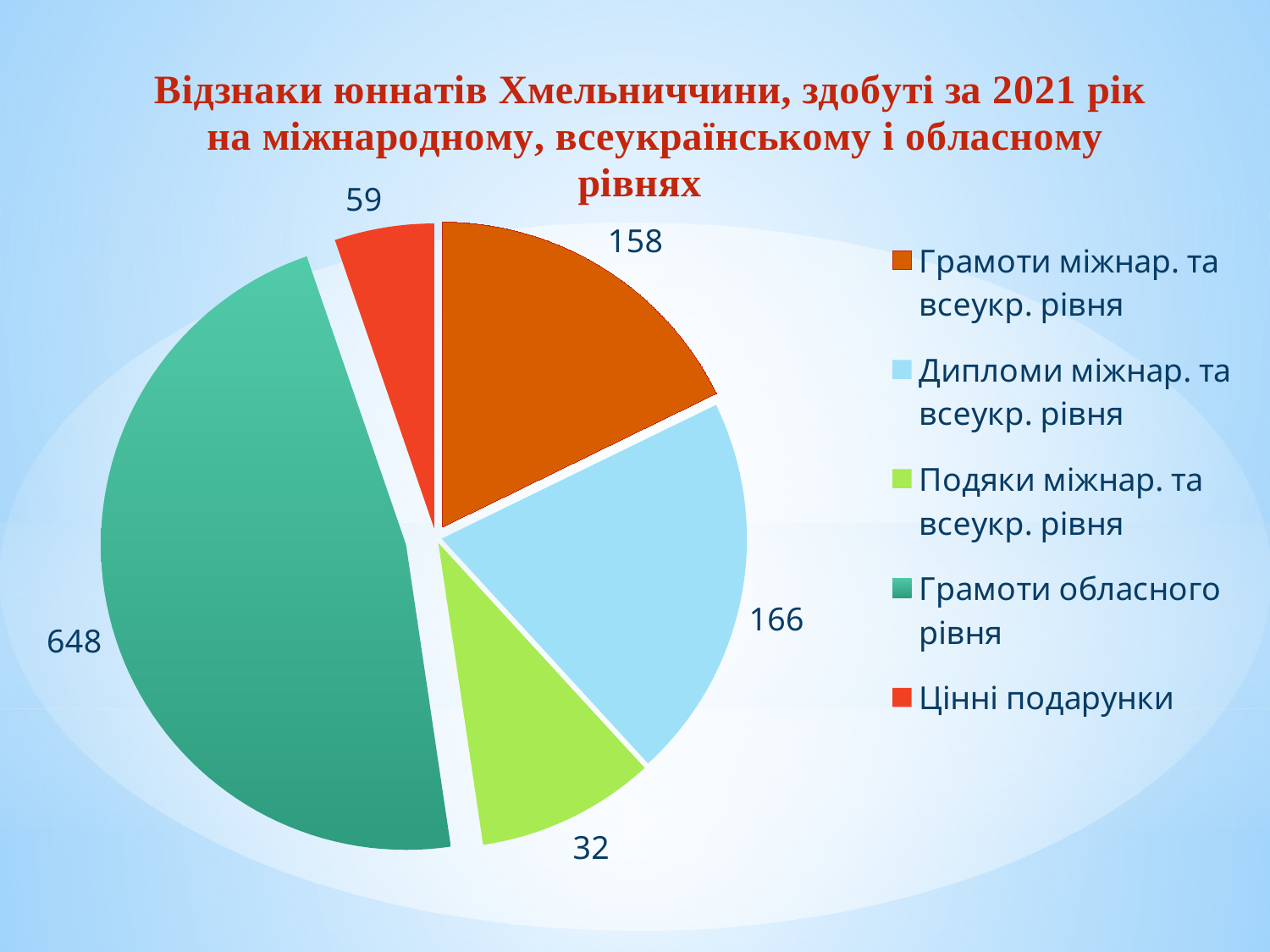
Which category has the largest slice? Грамоти обласного рівня What is the value for Цінні подарунки? 59 How many slices does the pie chart have? 5 What is the value for Дипломи міжнар. та всеукр. рівня? 166 What is the difference between Дипломи міжнар. та всеукр. рівня and Грамоти міжнар. та всеукр. рівня? 8 What is the total of all slices in the pie chart? 1063 What is the value for Грамоти обласного рівня? 648 What type of chart is shown on the slide? pie chart What colour is the slice for Грамоти обласного рівня? green (teal) How many entries does the legend list? 5